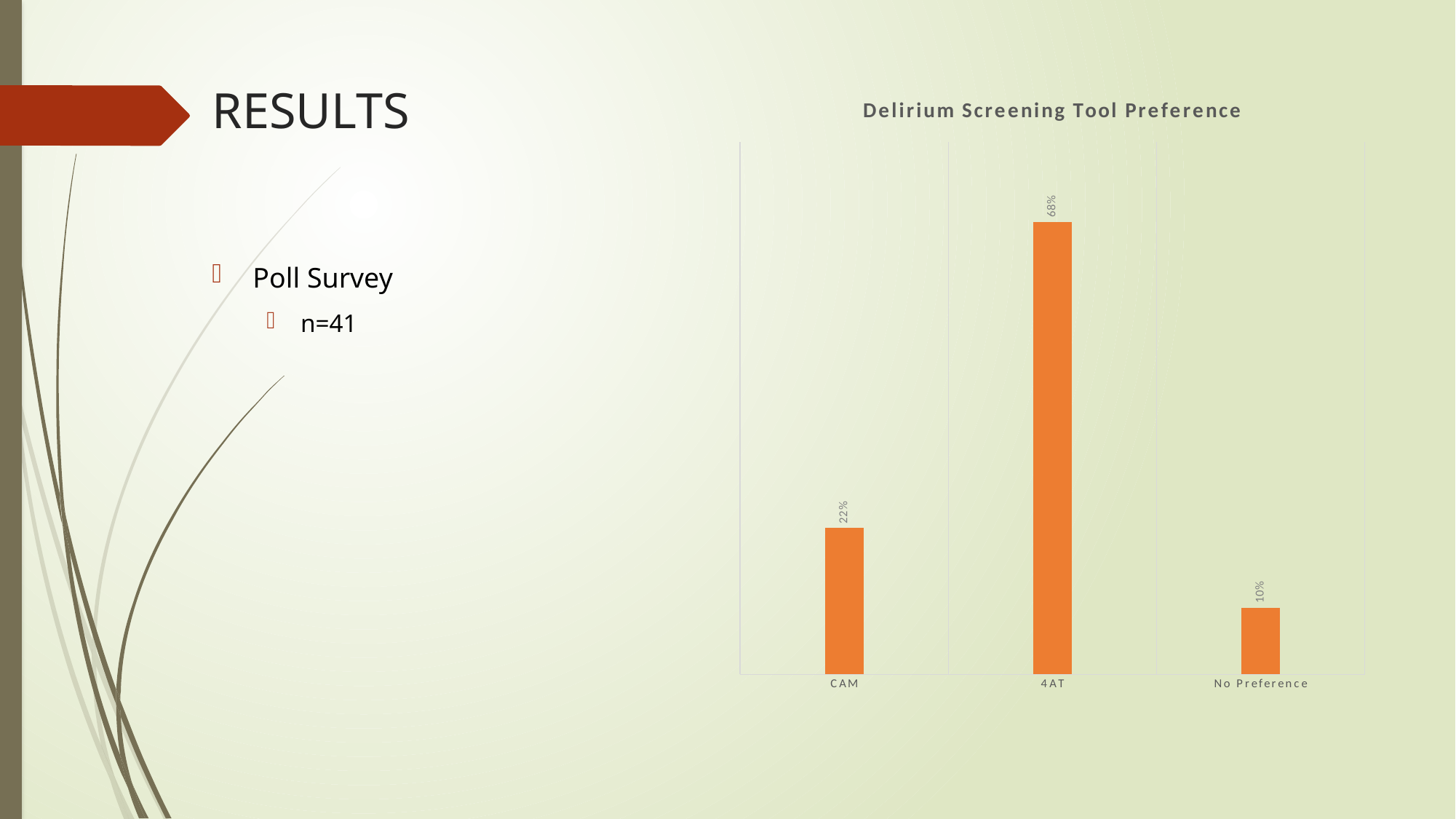
Which category has the highest value in the Delirium Screening Tool Preference chart? 4AT What is the value for CAM in the Delirium Screening Tool Preference chart? 22% What is the title of the chart on the slide? Delirium Screening Tool Preference Which category has the lowest value in the Delirium Screening Tool Preference chart? No Preference Which is larger, the value for CAM or the value for No Preference? CAM What is the difference between the values for 4AT and CAM? 46% What kind of chart is shown on the slide? Bar chart What is the value for No Preference in the Delirium Screening Tool Preference chart? 10% What is the difference between the values for CAM and No Preference? 12% What is the value for 4AT in the Delirium Screening Tool Preference chart? 68% What colour are the bars in the Delirium Screening Tool Preference chart? Orange How many categories are shown in the Delirium Screening Tool Preference chart? 3